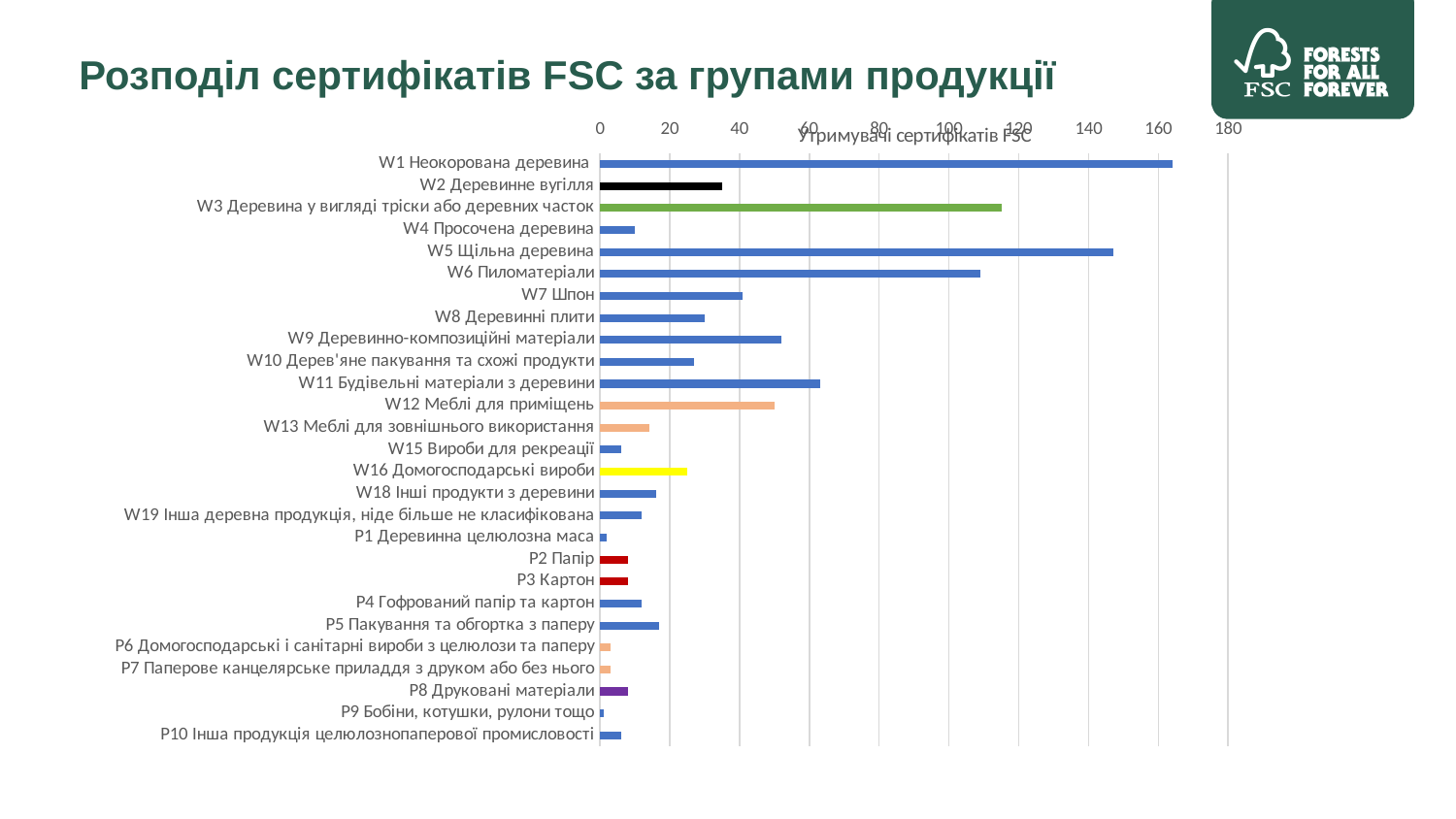
Which product group has the highest number of FSC certificate holders? W1 Неокорована деревина Which has more FSC certificate holders: W12 Меблі для приміщень or W13 Меблі для зовнішнього використання? W12 Меблі для приміщень Is the value for W1 Неокорована деревина greater or less than 140? greater Is the value for W16 Домогосподарські вироби greater or less than 20? greater Is the value for W12 Меблі для приміщень greater or less than 60? less What kind of chart is shown on the slide? bar chart Which has more FSC certificate holders: W5 Щільна деревина or W6 Пиломатеріали? W5 Щільна деревина What is the title of the chart on the slide? Розподіл сертифікатів FSC за групами продукції How many product group categories are plotted in the chart? 27 What is the label shown along the horizontal axis of the chart? Утримувачі сертифікатів FSC